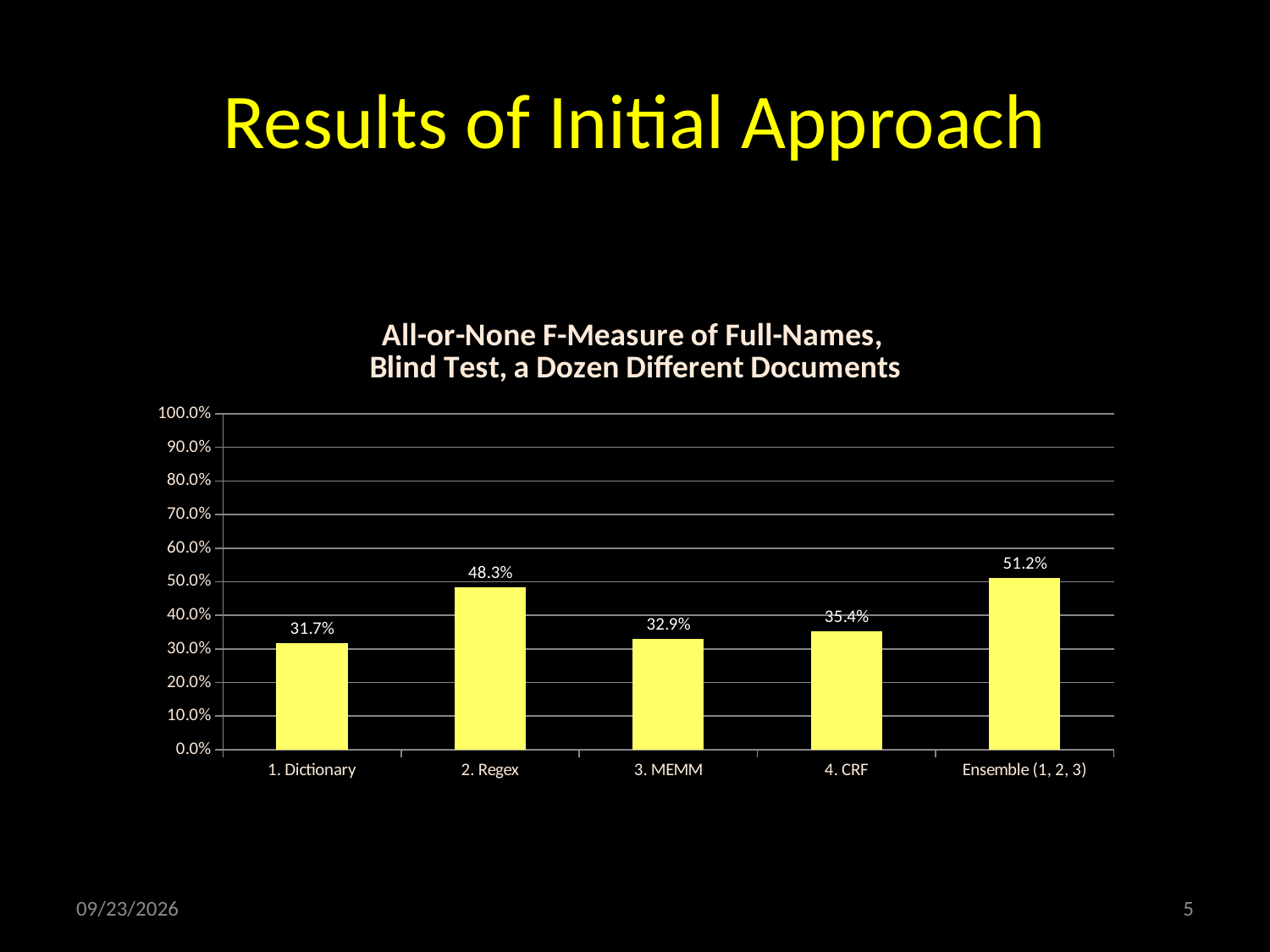
What is the value for 4. CRF? 35.4% What is the value for 3. MEMM? 32.9% What kind of chart is shown on the slide? bar chart Which is larger, the value for 4. CRF or the value for 3. MEMM? 4. CRF How many categories are shown on the x axis? 5 Is the value for 2. Regex greater or less than 40.0%? greater What is the value for 2. Regex? 48.3% Which category has the lowest value? 1. Dictionary Which category has the highest value? Ensemble (1, 2, 3) What is the value for Ensemble (1, 2, 3)? 51.2% What is the difference between the values for Ensemble (1, 2, 3) and 2. Regex? 2.9% What is the value for 1. Dictionary? 31.7%